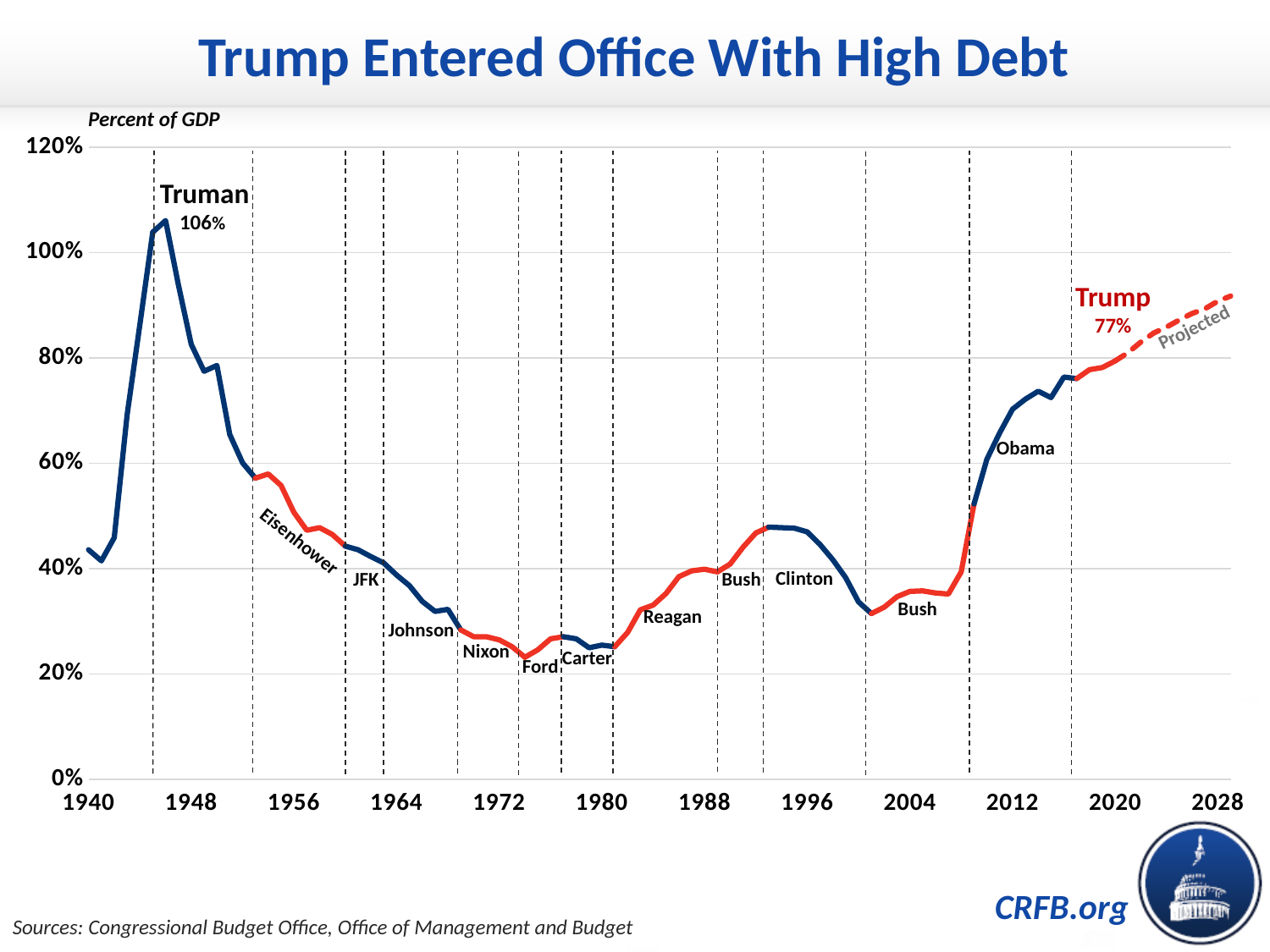
Is the value for 1996 greater or less than 60%? less Which is higher, the labeled Truman peak or the labeled Trump value? Truman Between 1948 and 1972, does the line generally rise or fall? Fall What kind of chart is shown on the slide? Line chart What debt value is labeled for Trump? 77% Is the value for 1980 greater or less than 40%? less What is the difference between the Truman peak (106%) and the Trump value (77%)? 29 percentage points Is the value for 2012 greater or less than 60%? greater What is the peak debt value labeled under Truman? 106% What does the dashed red portion of the line at the right represent? Projected What is the title of the chart? Trump Entered Office With High Debt Under which president does the chart reach its highest value? Truman